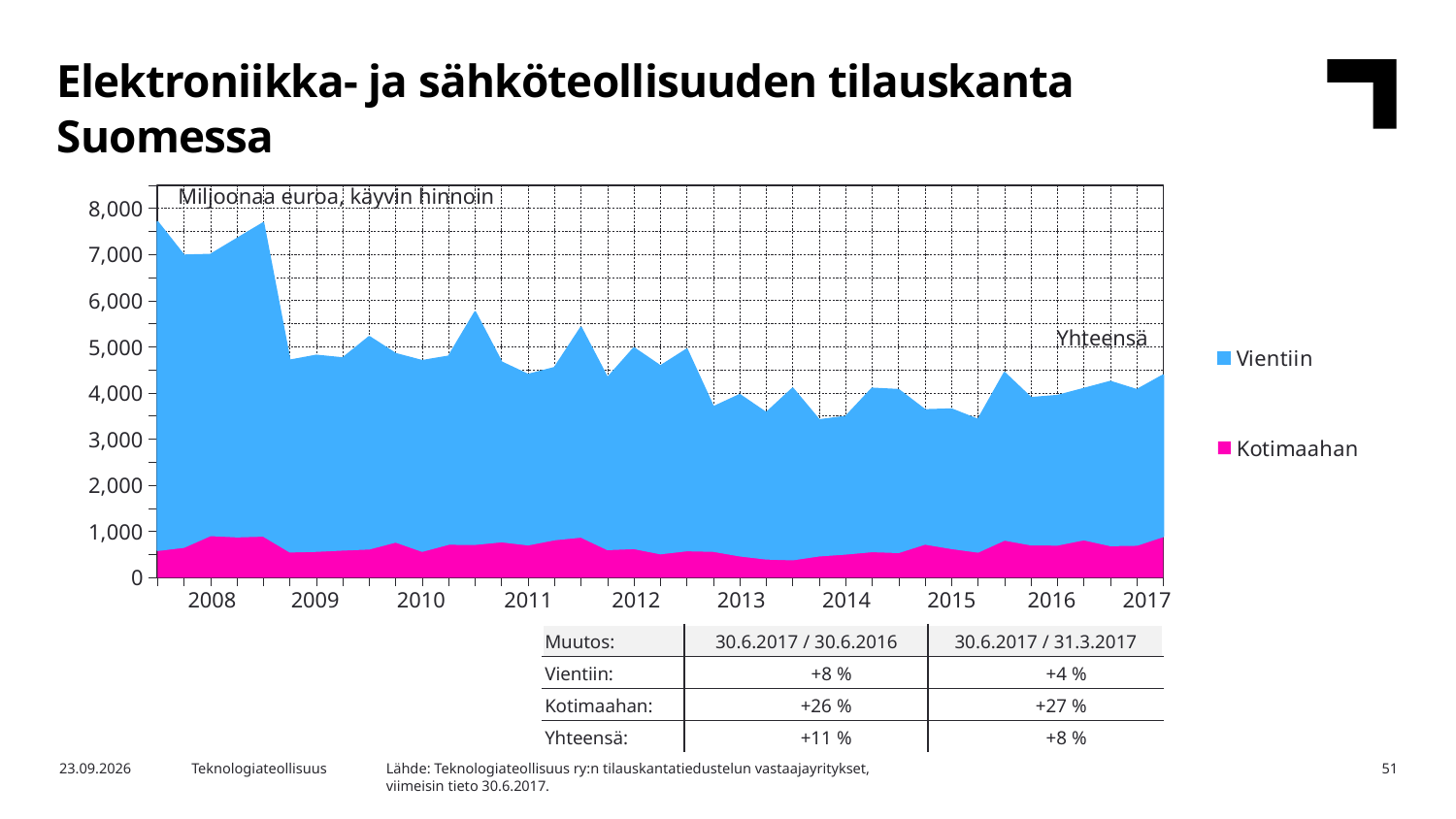
What unit label is shown at the top of the chart area? Miljoonaa euroa, käyvin hinnoin In which year does the total order stock reach its highest level? 2008 How many year labels are shown on the x axis? 10 Is the Kotimaahan value in 2017 greater or less than 1,000? less Is the total order stock (Yhteensä) in 2017 greater or less than 5,000? less Which is larger, the total order stock in 2008 or in 2017? 2008 What kind of chart is shown on the slide? Stacked area chart Overall, does the total order stock rise or fall from 2008 to 2017? fall How many series does the chart legend list? 2 What are the two series named in the chart legend? Vientiin and Kotimaahan